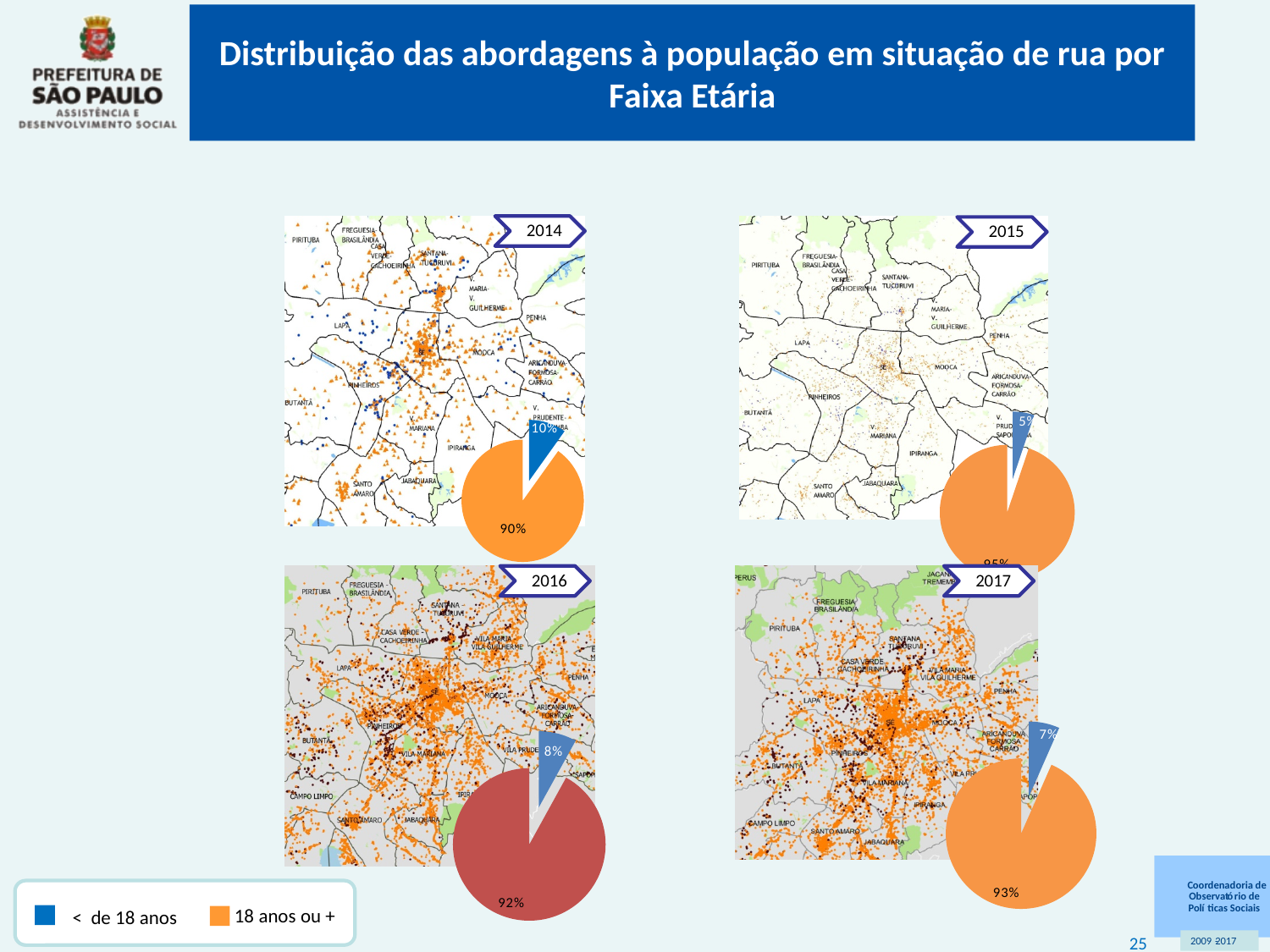
In the 2014 pie chart, what share is shown for '< de 18 anos'? 10% Across the four pie charts, which year shows the smallest share for '< de 18 anos'? 2015 In the 2017 pie chart, what share is shown for '18 anos ou +'? 93% What kind of chart is used to show the age distribution for each year? Pie chart What is the difference between the '< de 18 anos' share in the 2014 pie chart and in the 2017 pie chart? 3% In the 2015 pie chart, what share is shown for '< de 18 anos'? 5% Across the four pie charts, which year shows the largest share for '< de 18 anos'? 2014 In the 2017 pie chart, what share is shown for '< de 18 anos'? 7% In the 2016 pie chart, what share is shown for '< de 18 anos'? 8% In the 2016 pie chart, what share is shown for '18 anos ou +'? 92% How many categories does the legend at the bottom of the slide list? 2 In the 2014 pie chart, what share is shown for '18 anos ou +'? 90%